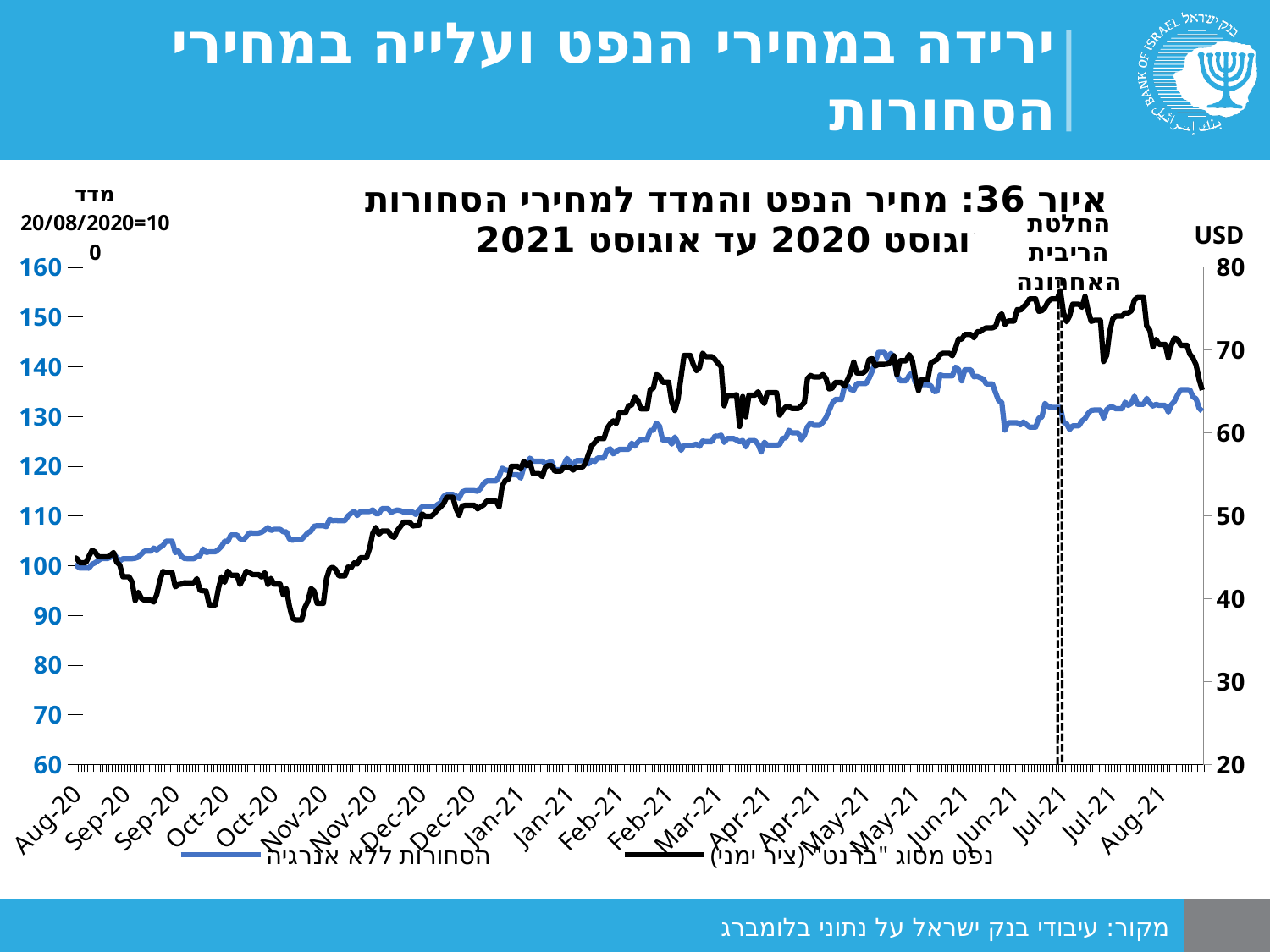
Does the Brent oil price rise or fall overall from Aug-20 to Jul-21? rise Does the blue commodities-excluding-energy index rise or fall overall from Aug-20 to Aug-21? rise What event does the vertical dashed line in the chart mark? החלטת הריבית האחרונה At its lowest point in Nov-20, is the Brent oil price (right axis) greater or less than 40? less At its peak in Jul-21, is the Brent oil price (right axis) greater or less than 70? greater Is the value of the blue commodities-excluding-energy index in Nov-20 greater or less than 100? greater Which series is plotted on the right axis according to the legend? נפט מסוג "ברנט" (ציר ימני) How many series does the legend list? 2 What kind of chart is shown on the slide? line chart